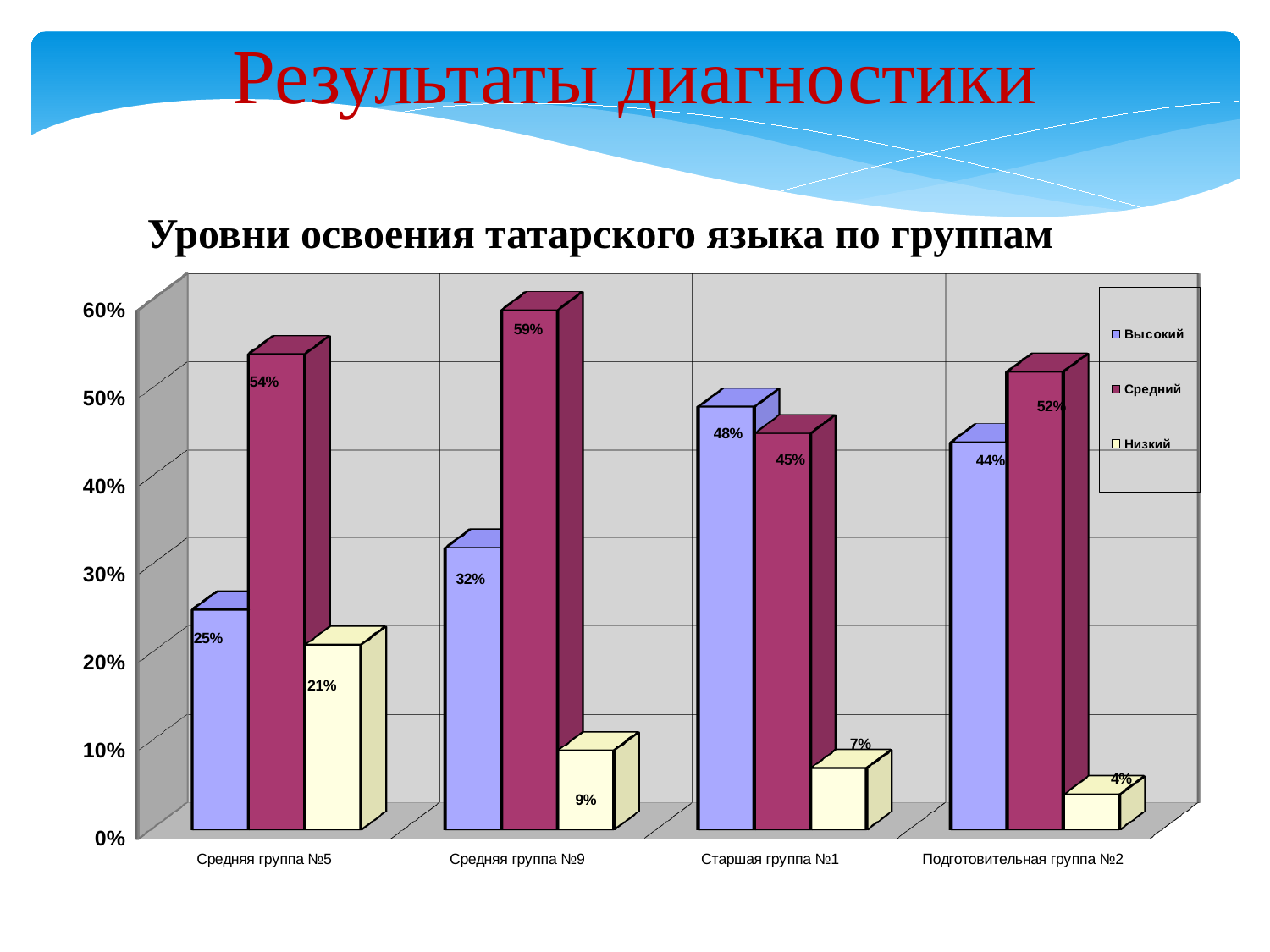
What is the value of Средний for Средняя группа №9? 59% How many series does the legend list? 3 What is the difference between the Средний and Высокий values for Средняя группа №5? 29% Which group has the lowest Низкий value? Подготовительная группа №2 What kind of chart is this? Bar chart Do the Низкий values rise or fall from left to right along the x axis? Fall What is the value of Низкий for Подготовительная группа №2? 4% Which is larger for Старшая группа №1: Высокий or Средний? Высокий What is the value of Высокий for Старшая группа №1? 48% What is the value of Высокий for Средняя группа №5? 25% Which group has the highest Средний value? Средняя группа №9 How many groups are shown on the x axis? 4